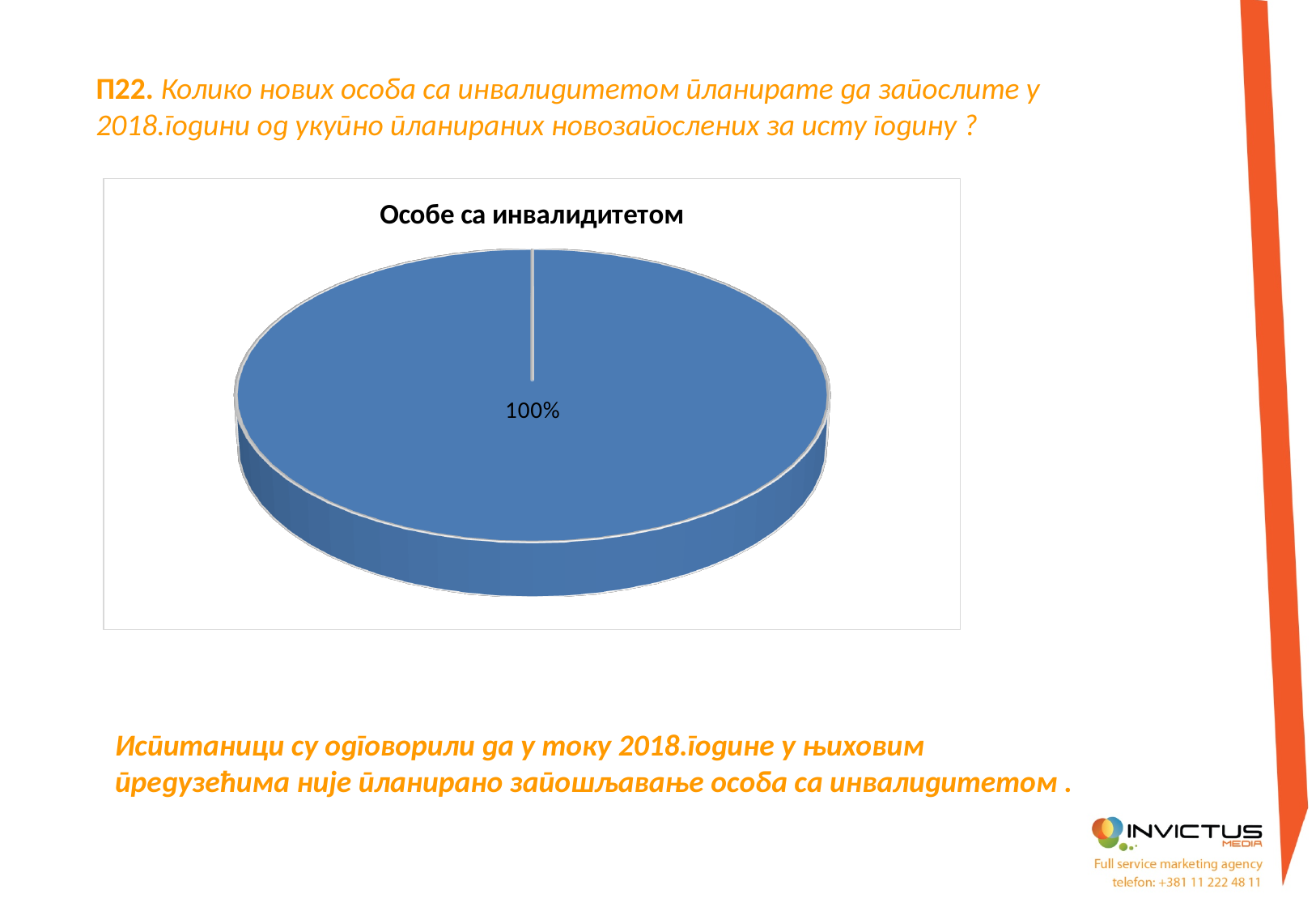
What kind of chart is shown on the slide? pie chart Is the value shown on the pie slice greater or less than 50%? greater What percentage is printed on the single slice of the pie chart? 100% What share of the pie does the only slice take up? 100% What colour is the slice of the pie chart? blue How many slices does the pie chart have? 1 What is the title of the chart? Особе са инвалидитетом